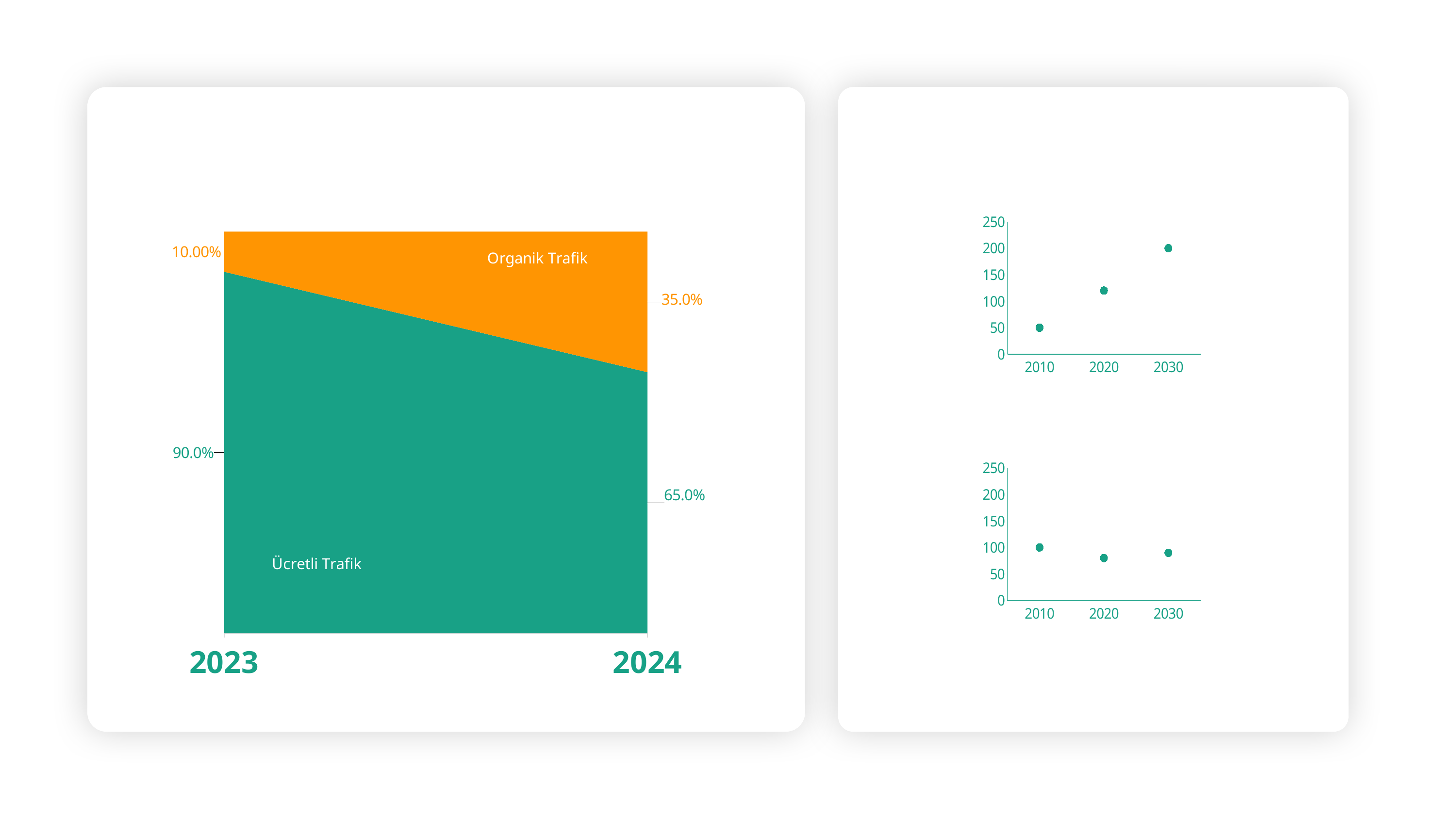
On the left chart, what is the value for Organik Trafik in 2024? 35.0% How many data points are plotted on the bottom-right chart? 3 On the left chart, what is the value for Ücretli Trafik in 2024? 65.0% On the left chart, which series has the larger value in 2024, Organik Trafik or Ücretli Trafik? Ücretli Trafik On the left chart, by how many percentage points does Organik Trafik change from 2023 to 2024? 25 percentage points On the top-right chart, is the value for 2020 greater or less than 100? greater On the left chart, does the Ücretli Trafik share rise or fall from 2023 to 2024? fall On the bottom-right chart, is the value for 2020 greater or less than 100? less On the left chart, what is the value for Organik Trafik in 2023? 10.00% What kind of chart is the left chart? stacked area chart On the top-right chart, which year has the highest value? 2030 On the left chart, what is the value for Ücretli Trafik in 2023? 90.0%